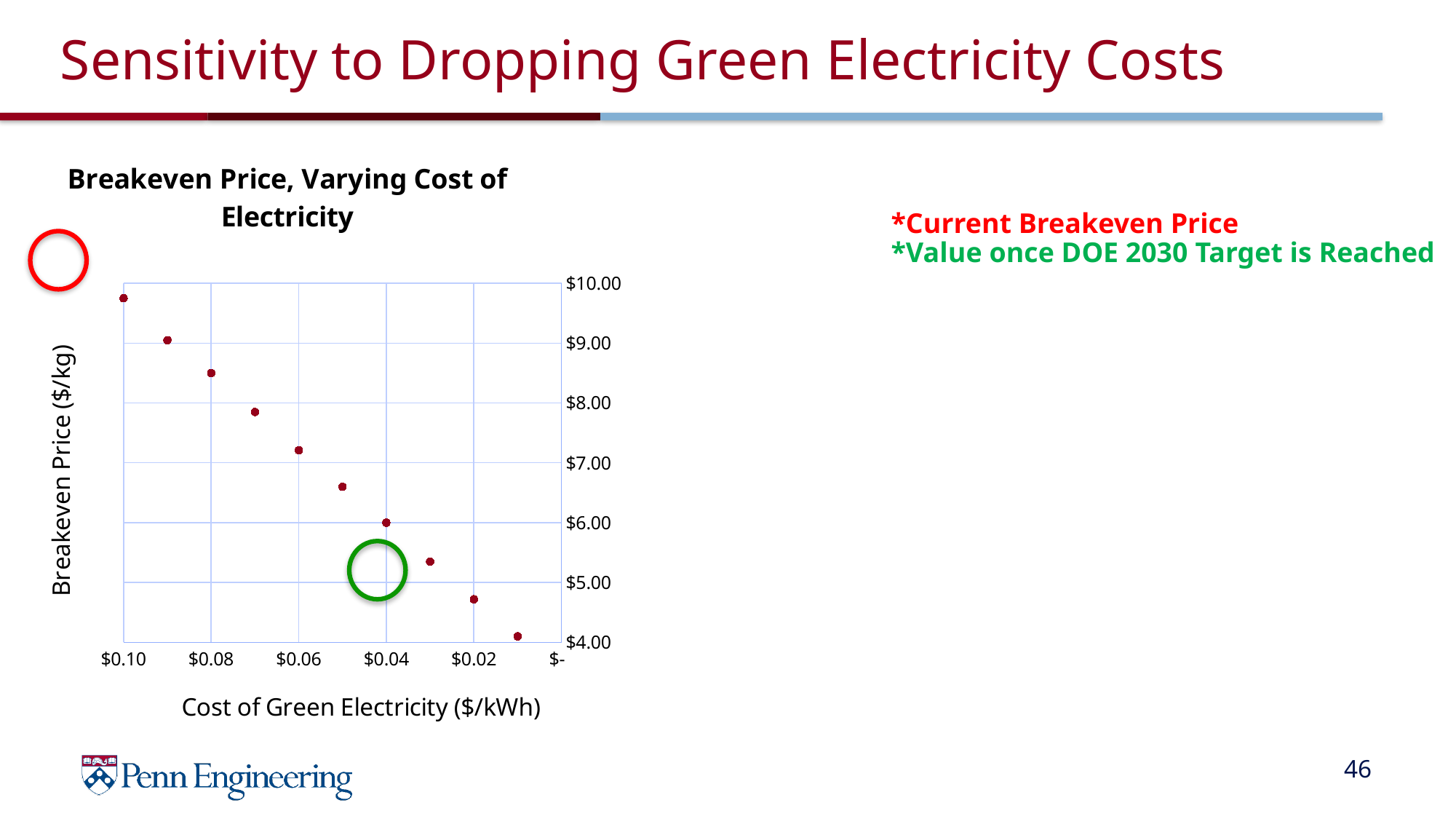
Do the plotted values rise or fall moving left to right along the x axis? fall Which has a higher breakeven price: a cost of $0.08 or a cost of $0.04? $0.08 What kind of chart is shown on the slide? scatter chart Is the breakeven price at a cost of $0.10 greater or less than $9.00? greater What is the title of the chart? Breakeven Price, Varying Cost of Electricity Is the breakeven price at a cost of $0.02 greater or less than $5.00? less Is the breakeven price at a cost of $0.06 greater or less than $7.00? greater At which cost of green electricity is the breakeven price highest? $0.10 What is the label of the y axis? Breakeven Price ($/kg) How many data points are plotted in the chart? 10